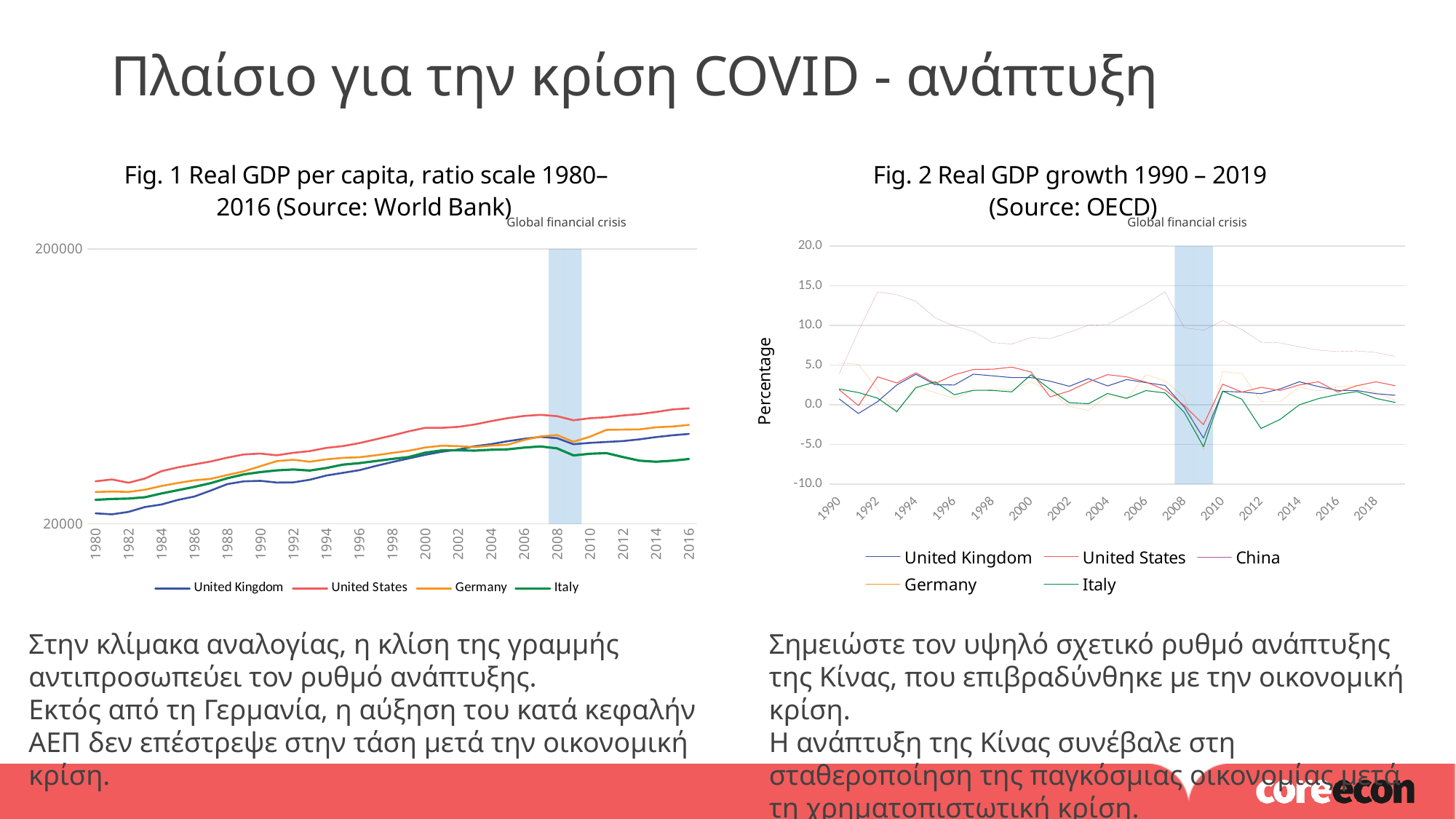
What kind of chart is Fig. 2 Real GDP growth 1990 – 2019? line chart How many series does the legend of Fig. 1 Real GDP per capita list? 4 In Fig. 2 Real GDP growth, is the value for Italy in 2009 greater or less than 0.0? less In Fig. 1 Real GDP per capita, which country has the lowest line in 2016? Italy Which series appears in the legend of Fig. 2 but not in the legend of Fig. 1? China In Fig. 1 Real GDP per capita, is the line for Germany or Italy higher in 2016? Germany In Fig. 2 Real GDP growth, is the value for China in 1992 greater or less than 10.0? greater In Fig. 1 Real GDP per capita, does the United States line rise or fall from 1980 to 2016? rise How many series does the legend of Fig. 2 Real GDP growth list? 5 What kind of chart is Fig. 1 Real GDP per capita? line chart In Fig. 2 Real GDP growth, which country has the highest growth rate in 2007? China In Fig. 1 Real GDP per capita, which country has the highest line in 2016? United States